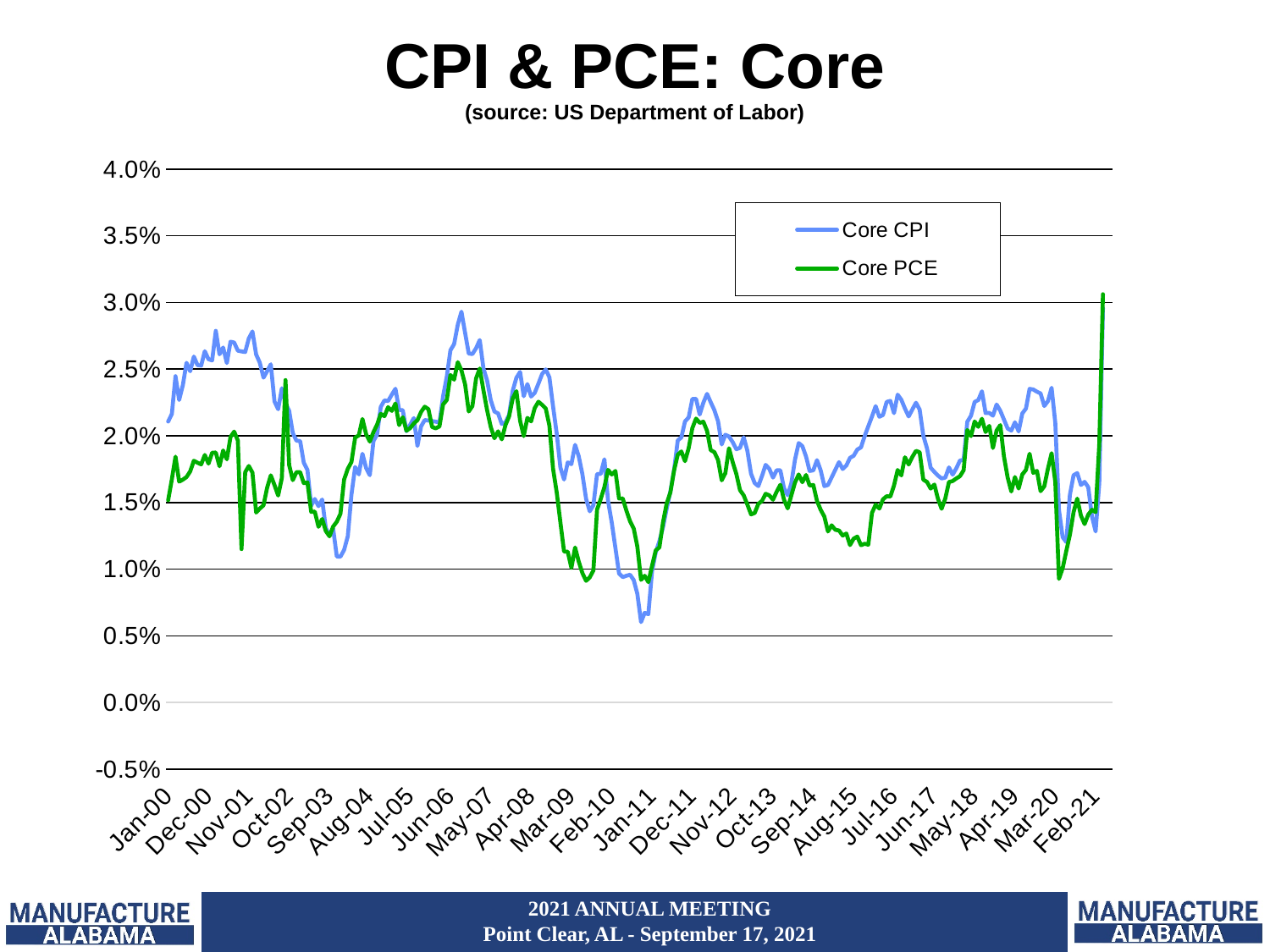
At Jan-00, which series has the higher value, Core CPI or Core PCE? Core CPI At the far right end of the chart (Feb-21), which series has the higher value, Core CPI or Core PCE? Core PCE How many series does the legend list? 2 Is the lowest value of Core CPI, reached around Jan-11, greater or less than 1.0%? less Is the value of Core PCE around Aug-15 greater or less than 1.5%? less What source is cited under the chart title? US Department of Labor How many date labels are shown along the x axis? 24 What are the two series named in the legend? Core CPI and Core PCE Is the peak of Core CPI around May-07 greater or less than 2.5%? greater What kind of chart is shown on the slide? Line chart Which series reaches the single lowest point on the chart? Core CPI